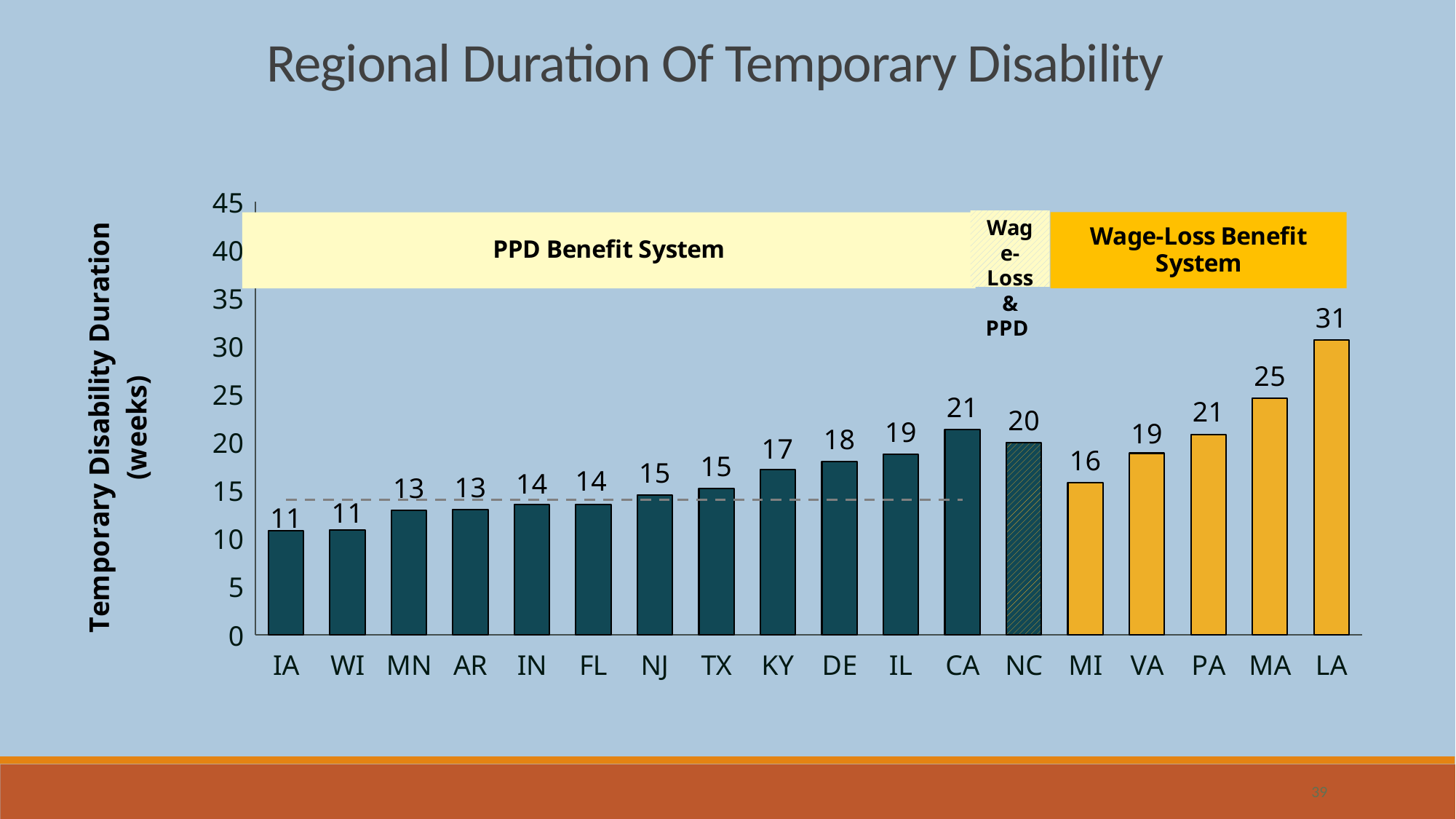
What is the temporary disability duration for NC? 20 Which has a longer temporary disability duration, DE or VA? VA What is the temporary disability duration for LA? 31 What type of chart is shown on the slide? Bar chart What is the temporary disability duration for KY? 17 Which states have the lowest temporary disability duration? IA and WI How many states are shown on the x axis of the chart? 18 What is the difference in temporary disability duration between LA and MA? 6 What is the title of the chart on the slide? Regional Duration Of Temporary Disability What is the difference in temporary disability duration between CA and IA? 10 What is the temporary disability duration for MI? 16 Which state has the highest temporary disability duration? LA